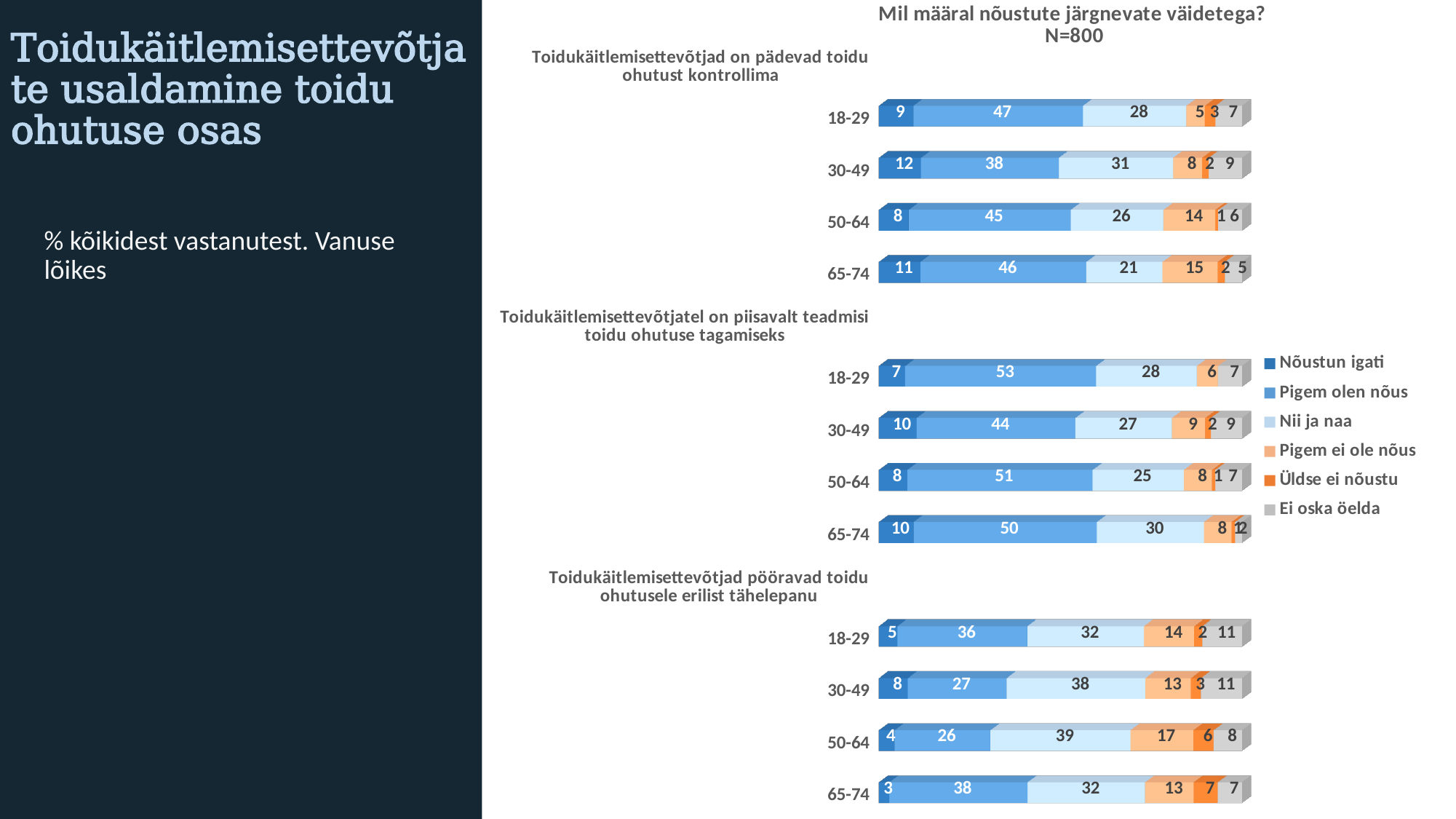
For the statement 'Toidukäitlemisettevõtjad on pädevad toidu ohutust kontrollima', what is the 'Pigem olen nõus' value for the 18-29 age group? 47 For the statement 'Toidukäitlemisettevõtjad on pädevad toidu ohutust kontrollima', what is the 'Pigem ei ole nõus' value for the 65-74 age group? 15 For the statement 'Toidukäitlemisettevõtjad pööravad toidu ohutusele erilist tähelepanu', what is the difference between the 'Nii ja naa' values for the 50-64 and 18-29 age groups? 7 For the statement 'Toidukäitlemisettevõtjatel on piisavalt teadmisi toidu ohutuse tagamiseks', which age group has the highest 'Pigem olen nõus' value? 18-29 For the statement 'Toidukäitlemisettevõtjad pööravad toidu ohutusele erilist tähelepanu', which age group has the lowest 'Nõustun igati' value? 65-74 For the statement 'Toidukäitlemisettevõtjatel on piisavalt teadmisi toidu ohutuse tagamiseks', what is the 'Ei oska öelda' value for the 30-49 age group? 9 How many series does the legend list? 6 How many age groups are shown for each statement in the chart? 4 For the statement 'Toidukäitlemisettevõtjad pööravad toidu ohutusele erilist tähelepanu', what is the 'Üldse ei nõustu' value for the 65-74 age group? 7 What kind of chart is shown on the slide? Stacked bar chart What is the sample size (N) stated in the chart title? N=800 For the statement 'Toidukäitlemisettevõtjad on pädevad toidu ohutust kontrollima', which age group has a larger 'Nõustun igati' value: 30-49 or 50-64? 30-49